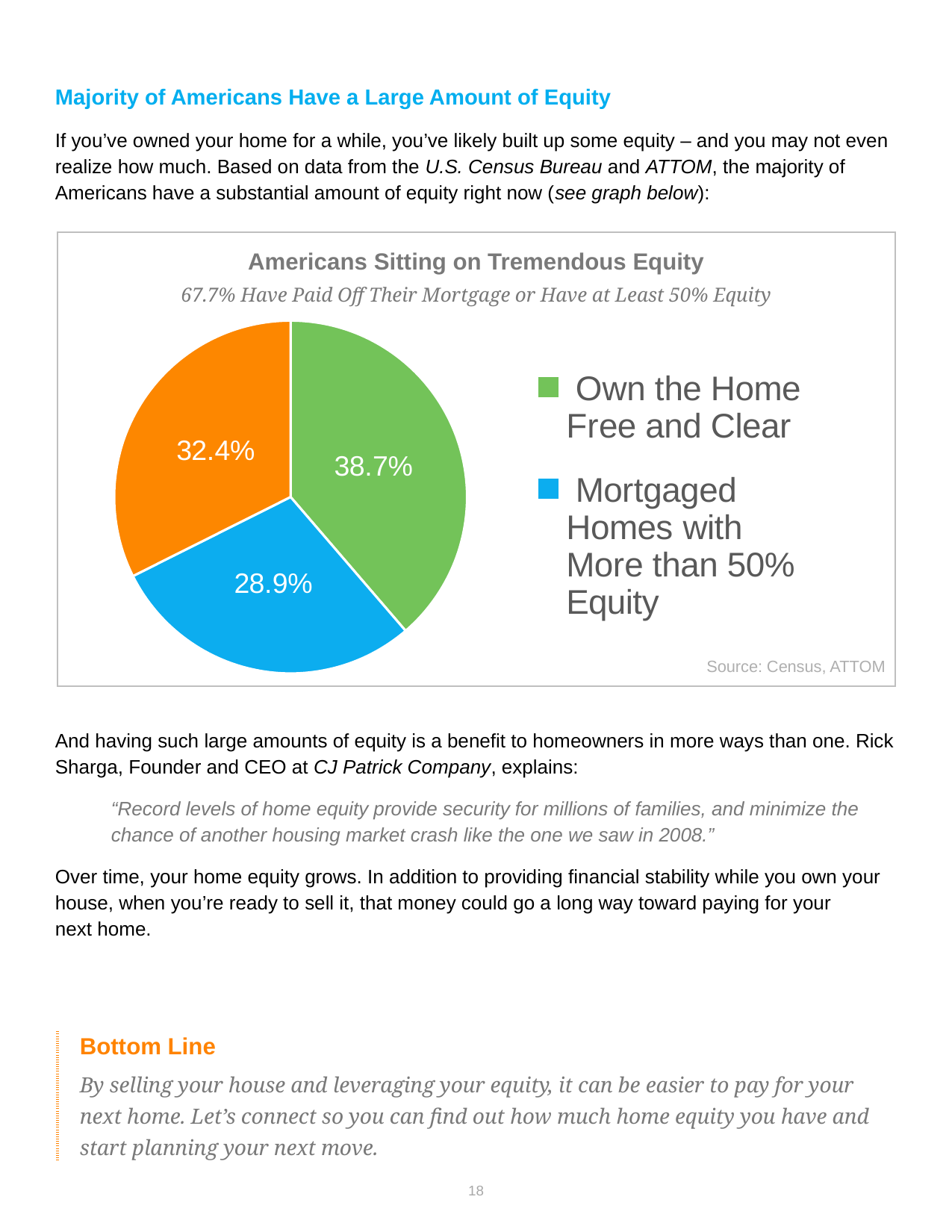
Which is larger: Own the Home Free and Clear or Mortgaged Homes with More than 50% Equity? Own the Home Free and Clear How many entries does the legend list? 2 What percentage of the pie is labelled for Own the Home Free and Clear? 38.7% What kind of chart is shown on the slide? Pie chart What colour is the slice for Own the Home Free and Clear? Green Which slice of the pie is the largest? Own the Home Free and Clear What percentage is shown for Mortgaged Homes with More than 50% Equity? 28.9% What value is printed on the orange slice of the pie? 32.4% What is the title of the chart? Americans Sitting on Tremendous Equity Which slice of the pie is the smallest? Mortgaged Homes with More than 50% Equity How many slices does the pie chart have? 3 What is the difference in percentage points between Own the Home Free and Clear and Mortgaged Homes with More than 50% Equity? 9.8